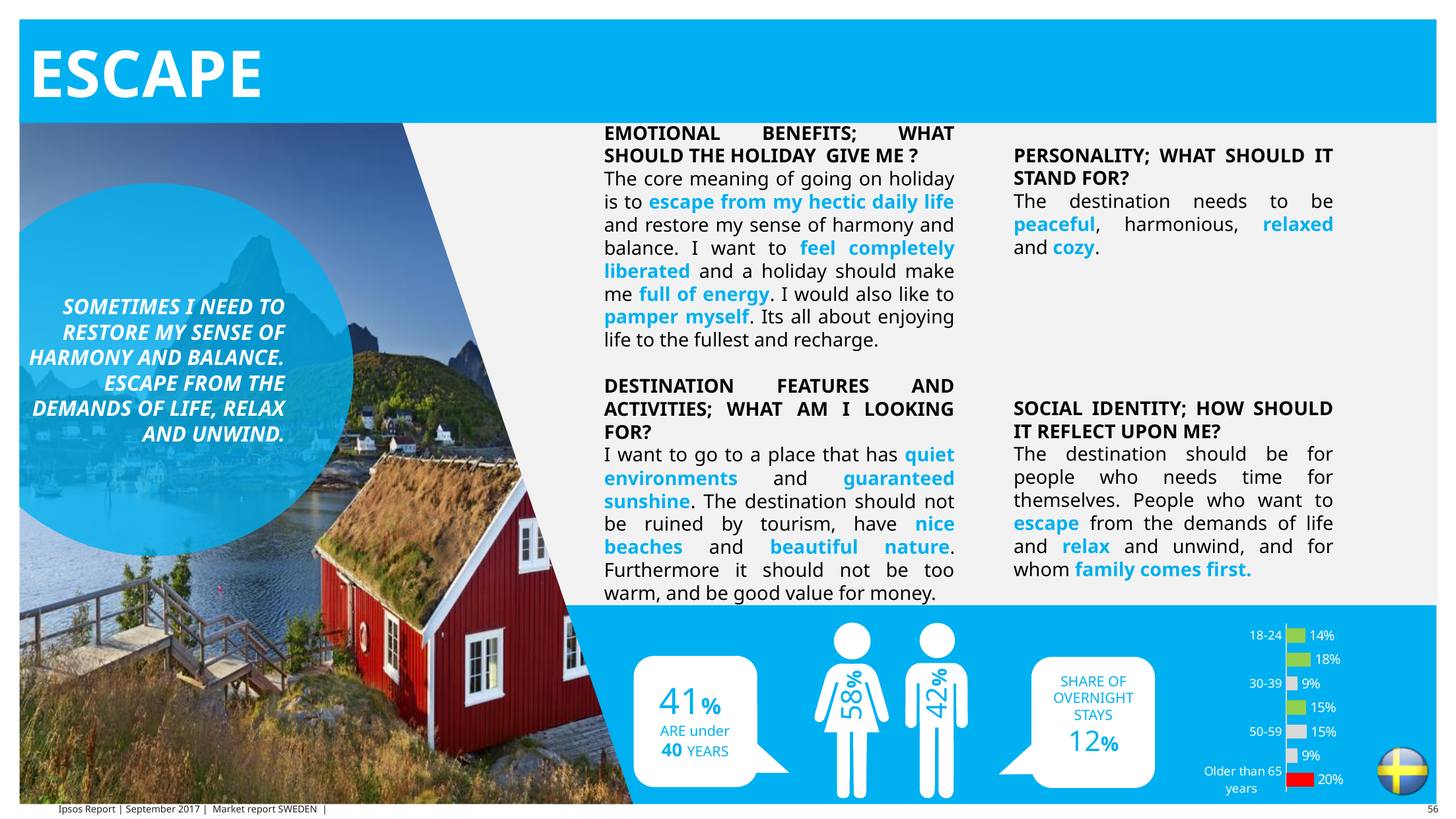
In the bar chart at the bottom right, which age group has the highest value? Older than 65 years In the bar chart at the bottom right, what is the value for the 'Older than 65 years' group? 20% What kind of chart is shown at the bottom right of the slide? Bar chart How many bars are plotted in the bar chart at the bottom right? 7 In the bar chart at the bottom right, which has the larger value, 50-59 or 'Older than 65 years'? Older than 65 years In the bar chart at the bottom right, what is the value for the 30-39 age group? 9% In the bar chart at the bottom right, what is the value for the 18-24 age group? 14% In the bar chart at the bottom right, what is the difference between the value for 50-59 and the value for 30-39? 6% In the bar chart at the bottom right, which has the larger value, 18-24 or 30-39? 18-24 In the bar chart at the bottom right, what is the difference between the value for 'Older than 65 years' and the value for 18-24? 6% In the bar chart at the bottom right, what colour is the bar for 'Older than 65 years'? Red In the bar chart at the bottom right, what is the value for the 50-59 age group? 15%